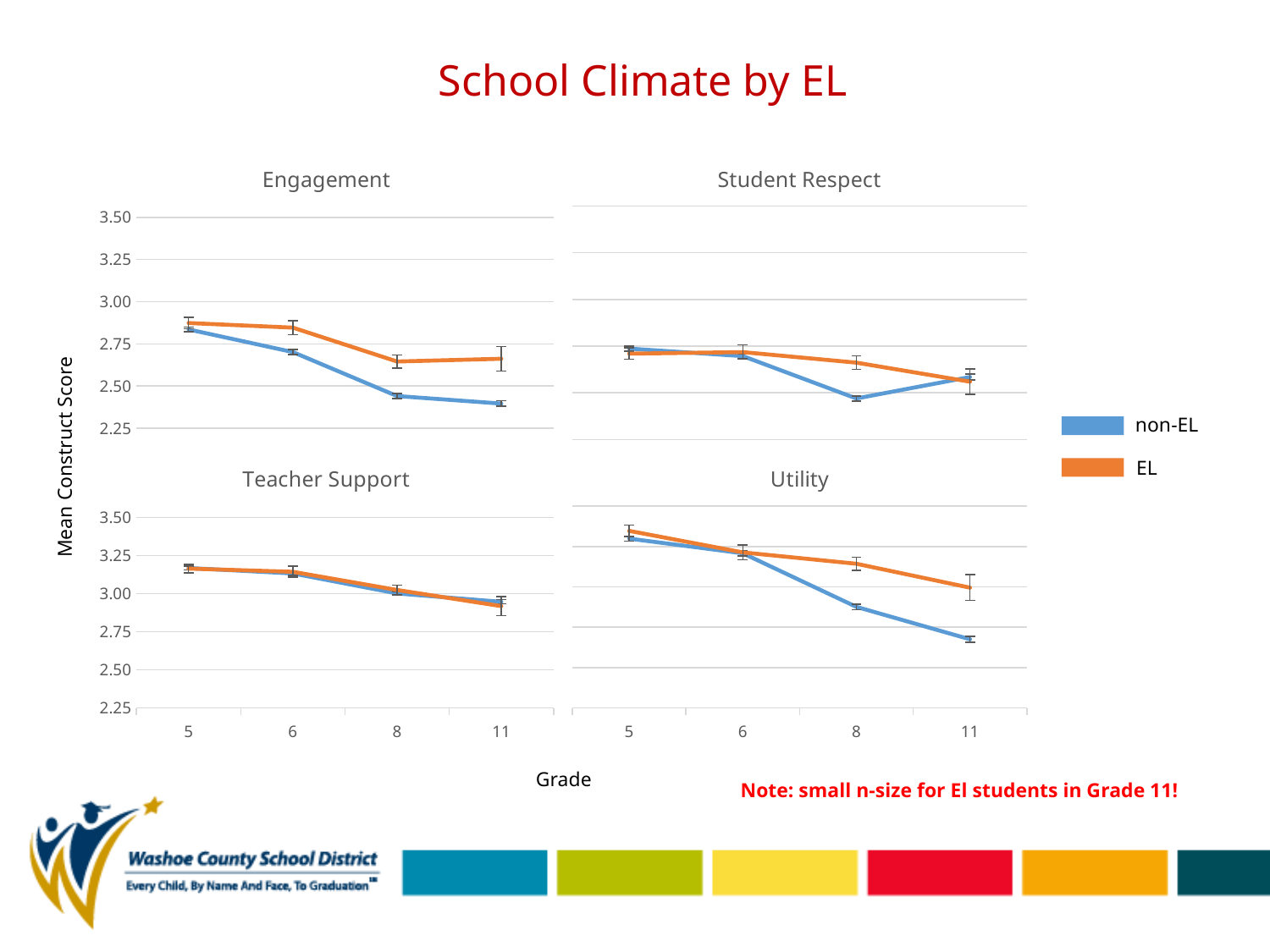
What kind of chart is used in the Engagement panel? line chart In the Teacher Support chart, is the non-EL value at grade 5 greater or less than 3.00? greater In the Utility chart, is the non-EL value at grade 11 greater or less than 3.00? less What is the label on the shared y axis of the charts? Mean Construct Score In the Utility chart, does the non-EL line rise or fall from grade 5 to grade 11? fall In the Engagement chart, is the non-EL value at grade 11 greater or less than 2.50? less In the Engagement chart, does the non-EL line rise or fall from grade 5 to grade 11? fall In the Engagement chart, which series has the higher value at grade 8, EL or non-EL? EL In the Utility chart, how many grade levels are plotted along the x axis? 4 How many series does the legend list? 2 In the Utility chart, which series has the higher value at grade 11, EL or non-EL? EL